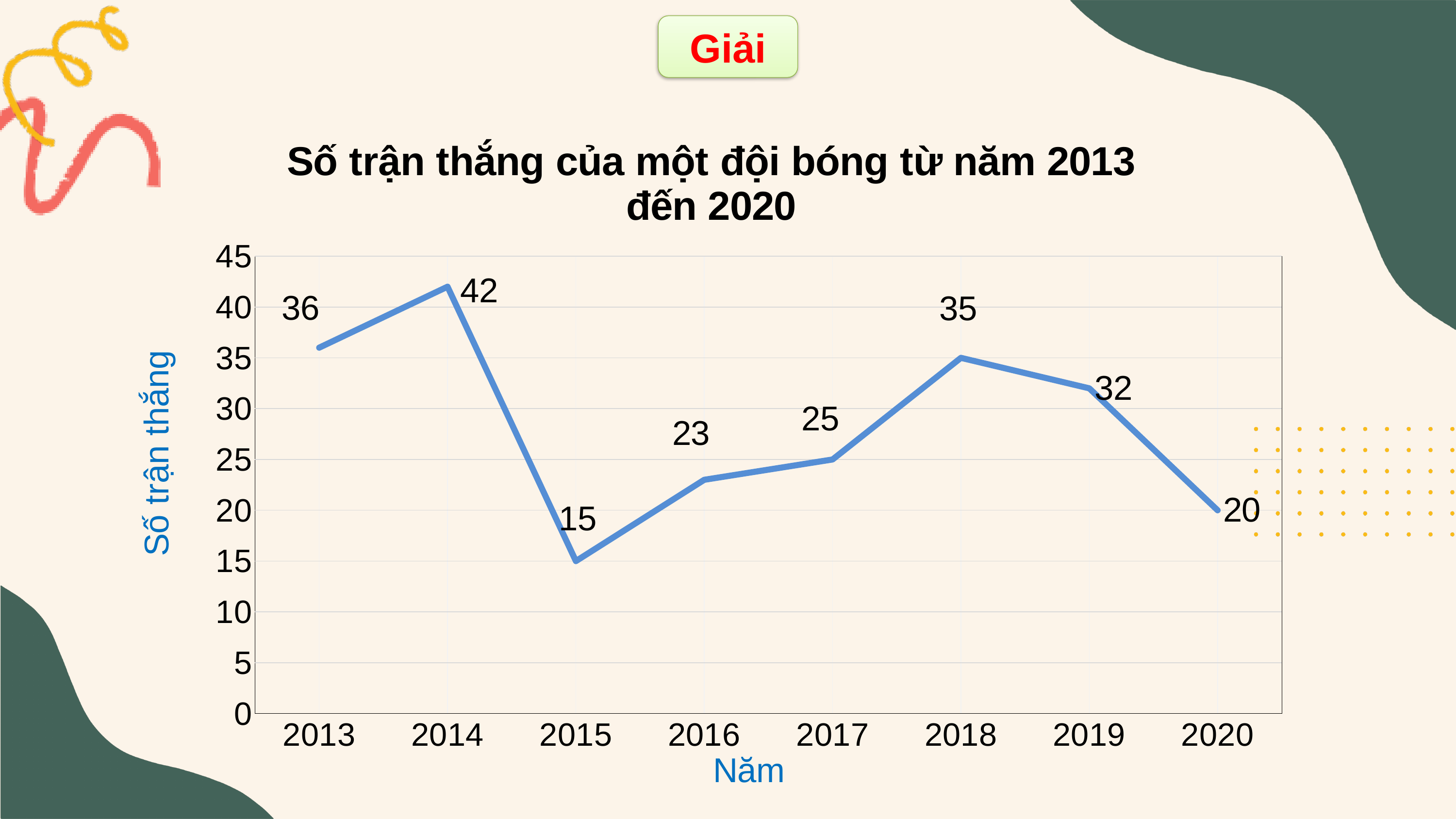
What is the title of the chart? Số trận thắng của một đội bóng từ năm 2013 đến 2020 How many wins did the team have in 2020? 20 Which year had the highest number of wins? 2014 Which year had more wins, 2013 or 2018? 2013 How many wins did the team have in 2014? 42 Did the number of wins rise or fall from 2015 to 2018? rise What is the difference between the number of wins in 2014 and in 2015? 27 How many wins did the team have in 2017? 25 How many years are plotted on the chart? 8 Which year had the lowest number of wins? 2015 What type of chart is shown on the slide? line chart What is the difference between the number of wins in 2018 and in 2019? 3